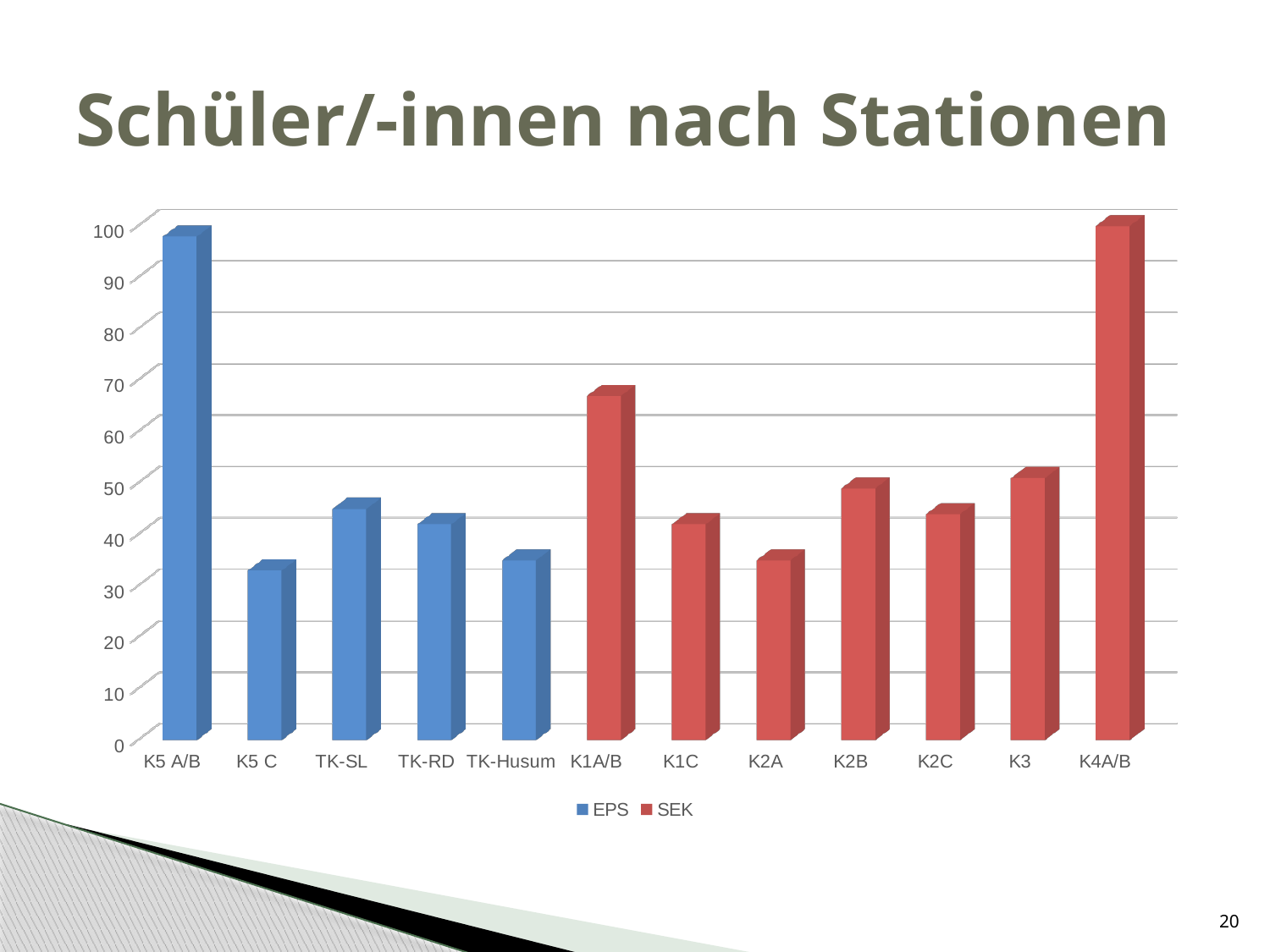
Is the value for K5 C greater or less than 40? less Is the value for K4A/B greater or less than 90? greater What is the title of the chart on the slide? Schüler/-innen nach Stationen Which is larger, the value for K1A/B or the value for K1C? K1A/B How many series does the legend list? 2 Among the EPS bars, which category has the highest value? K5 A/B Which is larger, the value for K2B or the value for K2A? K2B How many categories are shown on the x axis of the chart? 12 Is the value for K1A/B greater or less than 60? greater Which colour are the SEK bars in the chart? red Among the SEK bars, which category has the highest value? K4A/B What kind of chart is shown on the slide? bar chart